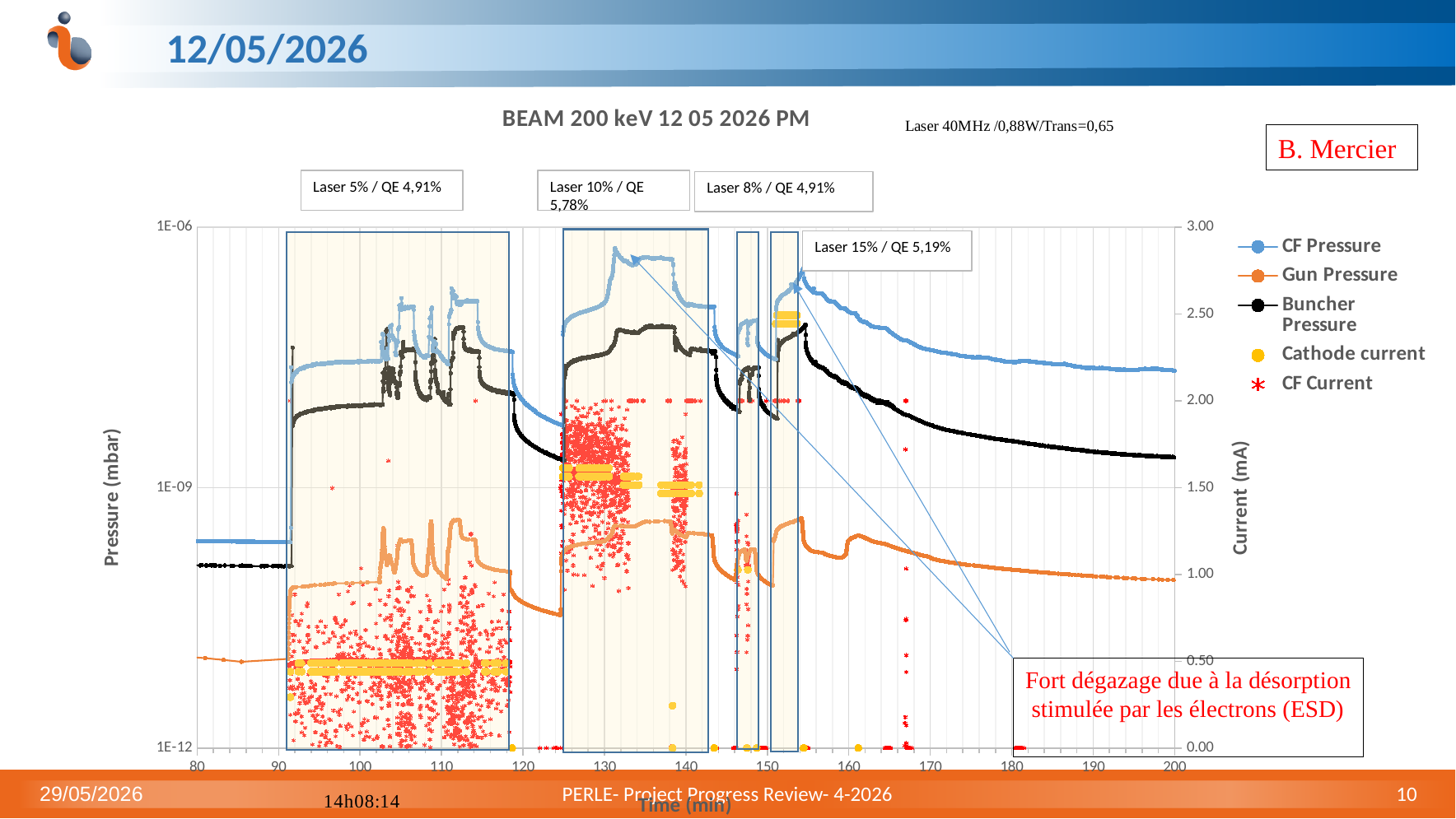
What is the title of the chart? BEAM 200 keV 12 05 2026 PM Which series is drawn in blue in the chart? CF Pressure At time 200 min, which is larger: CF Pressure or Gun Pressure? CF Pressure Does the Gun Pressure rise or fall between 160 min and 200 min? fall Is the Gun Pressure value at time 200 min greater or less than 1E-09 mbar? less How many series does the chart legend list? 5 Is the Buncher Pressure value at time 200 min greater or less than 1E-09 mbar? greater What kind of chart is shown on the slide? line chart Which series is plotted as red asterisks? CF Current Does the CF Pressure rise or fall between 160 min and 200 min? fall Is the CF Pressure value at time 80 min greater or less than 1E-09 mbar? less At time 200 min, which is larger: CF Pressure or Buncher Pressure? CF Pressure